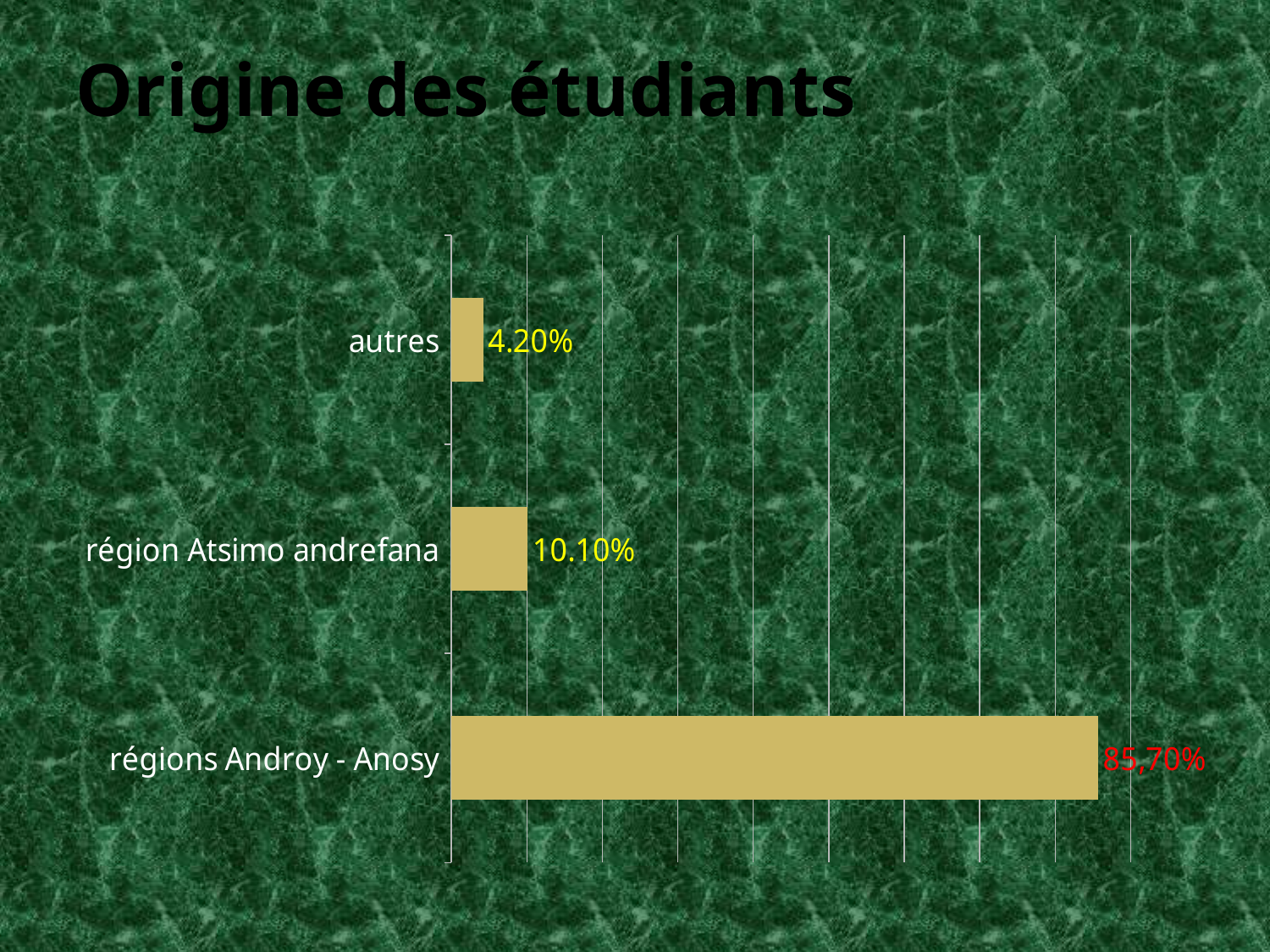
What is the value for régions Androy - Anosy? 85,70% What is the difference between the value for régions Androy - Anosy and the value for région Atsimo andrefana? 75.60% Which category has the lowest value? autres Which category has the highest value? régions Androy - Anosy How many categories are shown in the chart? 3 What is the value for autres? 4.20% Which is larger, the value for région Atsimo andrefana or the value for autres? région Atsimo andrefana Which data label is shown in red? 85,70% What kind of chart is shown on the slide? bar chart What is the difference between the value for région Atsimo andrefana and the value for autres? 5.90% What is the title of the slide? Origine des étudiants What is the value for région Atsimo andrefana? 10.10%